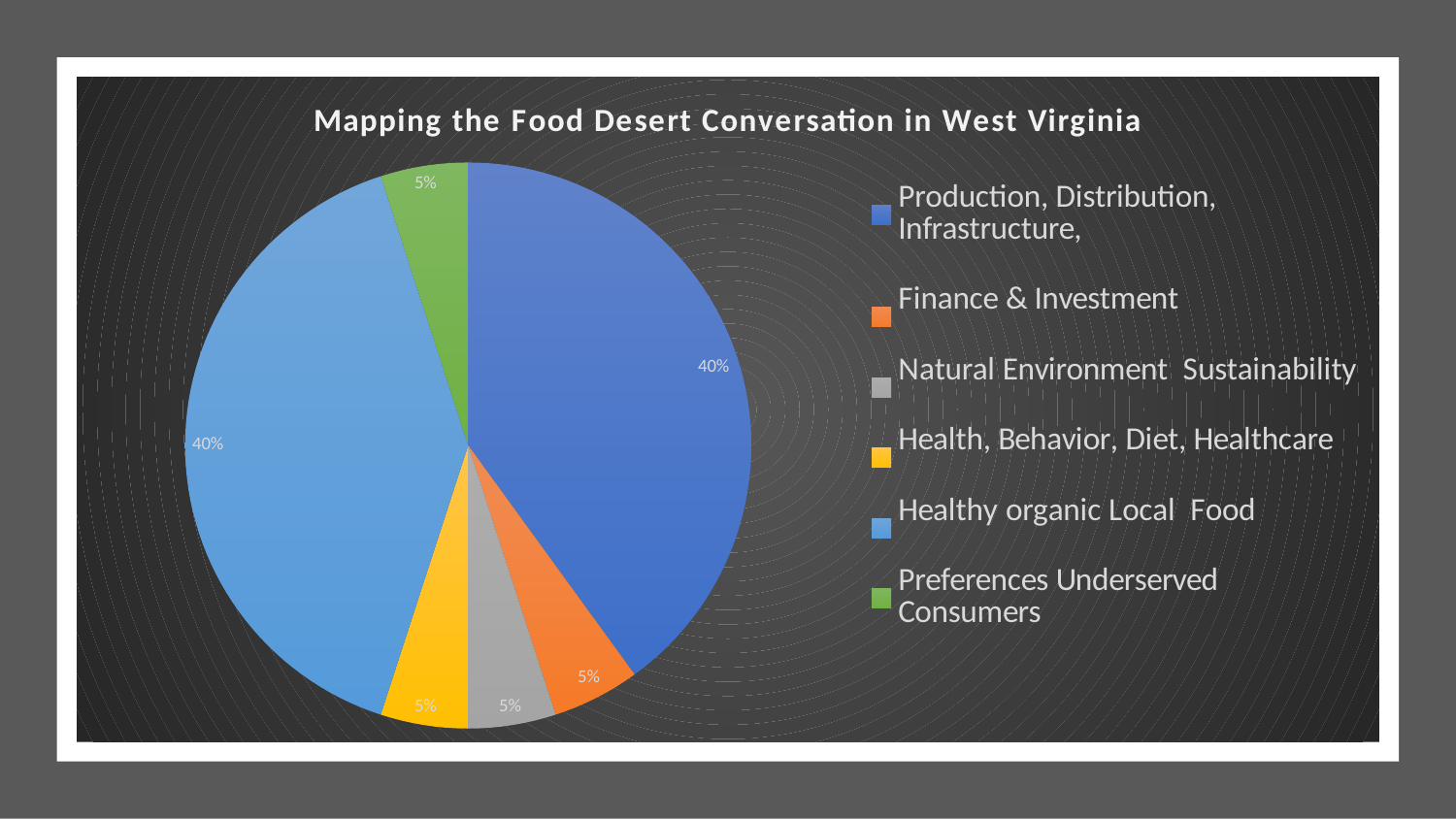
How many slices does the pie chart have? 6 What is the value for Health, Behavior, Diet, Healthcare? 5% What type of chart is shown on the slide? pie chart What share of the pie is Finance & Investment? 5% How many entries does the legend list? 6 What share of the pie is Production, Distribution, Infrastructure? 40% What share of the pie is Healthy organic Local Food? 40% Which is larger, Production, Distribution, Infrastructure or Natural Environment Sustainability? Production, Distribution, Infrastructure Which colour represents Healthy organic Local Food in the legend? light blue What is the title of the chart? Mapping the Food Desert Conversation in West Virginia What is the difference between the share for Healthy organic Local Food and the share for Finance & Investment? 35%